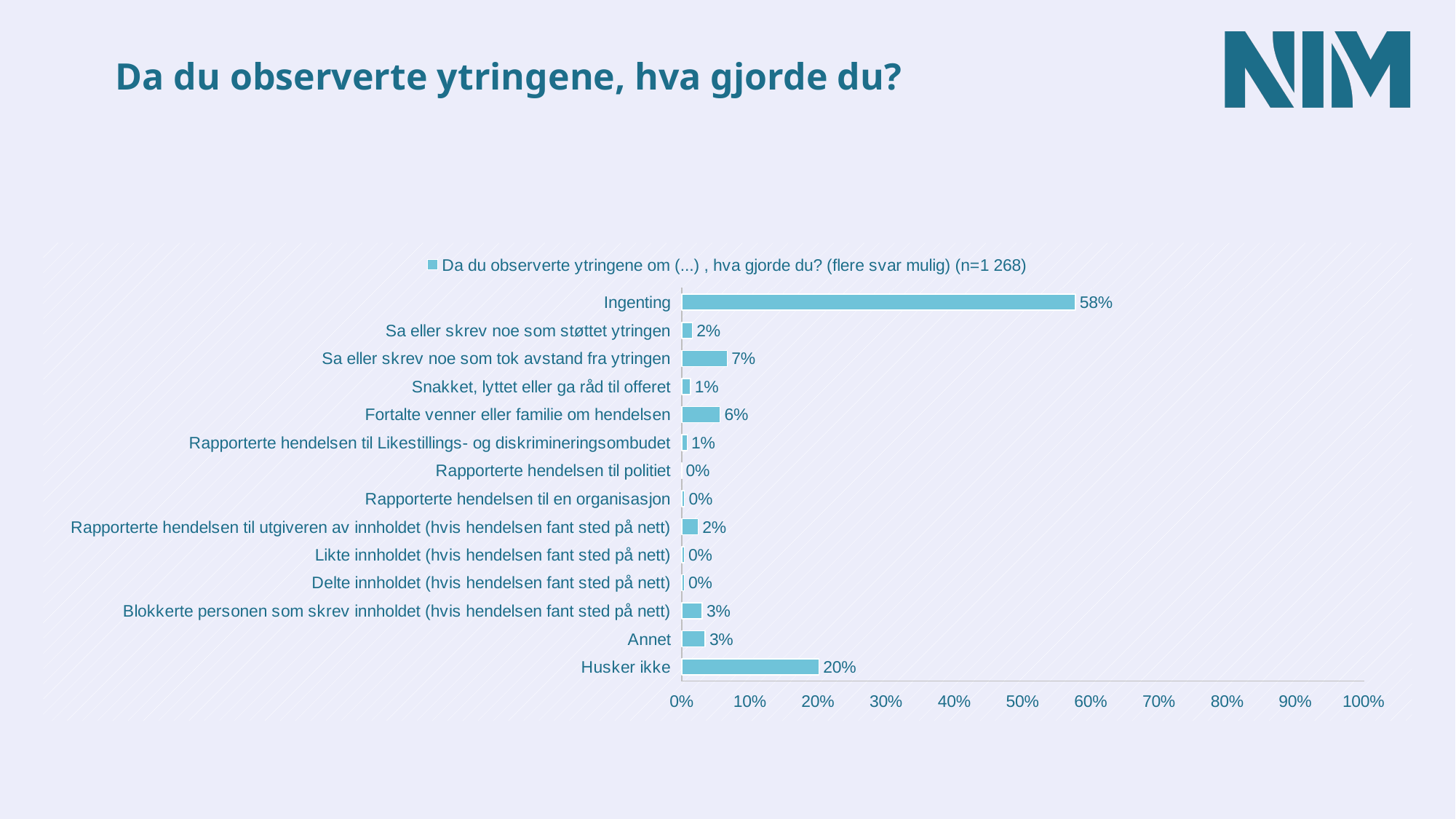
What kind of chart is shown on the slide? bar chart What is the value for "Sa eller skrev noe som tok avstand fra ytringen"? 7% Is the value for "Ingenting" greater or less than 50%? greater Which category has the highest value? Ingenting What is the value for "Husker ikke"? 20% What is the value for "Fortalte venner eller familie om hendelsen"? 6% What is the value for "Ingenting"? 58% How many categories are shown in the chart? 14 What is the difference between the values for "Ingenting" and "Husker ikke"? 38% What is the value for "Rapporterte hendelsen til politiet"? 0% How many series does the legend list? 1 Which is larger, the value for "Sa eller skrev noe som tok avstand fra ytringen" or the value for "Sa eller skrev noe som støttet ytringen"? Sa eller skrev noe som tok avstand fra ytringen